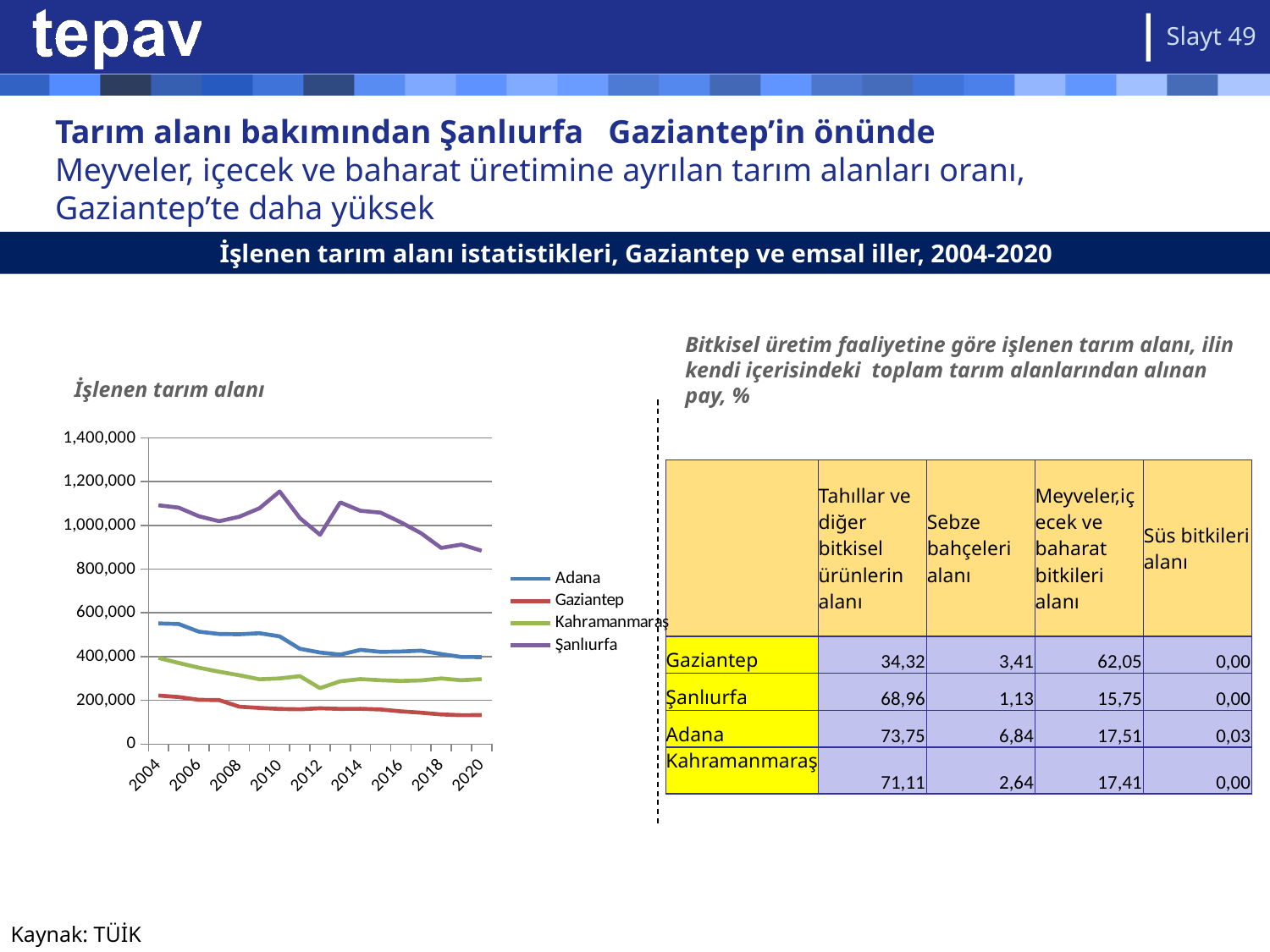
In the 'İşlenen tarım alanı' chart, is the value for Şanlıurfa in 2004 greater or less than 1,000,000? greater In the 'İşlenen tarım alanı' chart, does the Gaziantep series rise or fall from 2004 to 2020? fall In the 'İşlenen tarım alanı' chart, is the value for Gaziantep in 2020 greater or less than 200,000? less In the 'İşlenen tarım alanı' chart, is the value for Adana in 2004 greater or less than 400,000? greater What kind of chart is the 'İşlenen tarım alanı' chart? line chart How many series does the legend of the 'İşlenen tarım alanı' chart list? 4 Which series has the lowest values throughout the 'İşlenen tarım alanı' chart? Gaziantep What colour is the Şanlıurfa line in the 'İşlenen tarım alanı' chart? purple What is the title of the line chart on the left of the slide? İşlenen tarım alanı In the 'İşlenen tarım alanı' chart, which is larger in 2010: Adana or Kahramanmaraş? Adana Which series has the highest values throughout the 'İşlenen tarım alanı' chart? Şanlıurfa